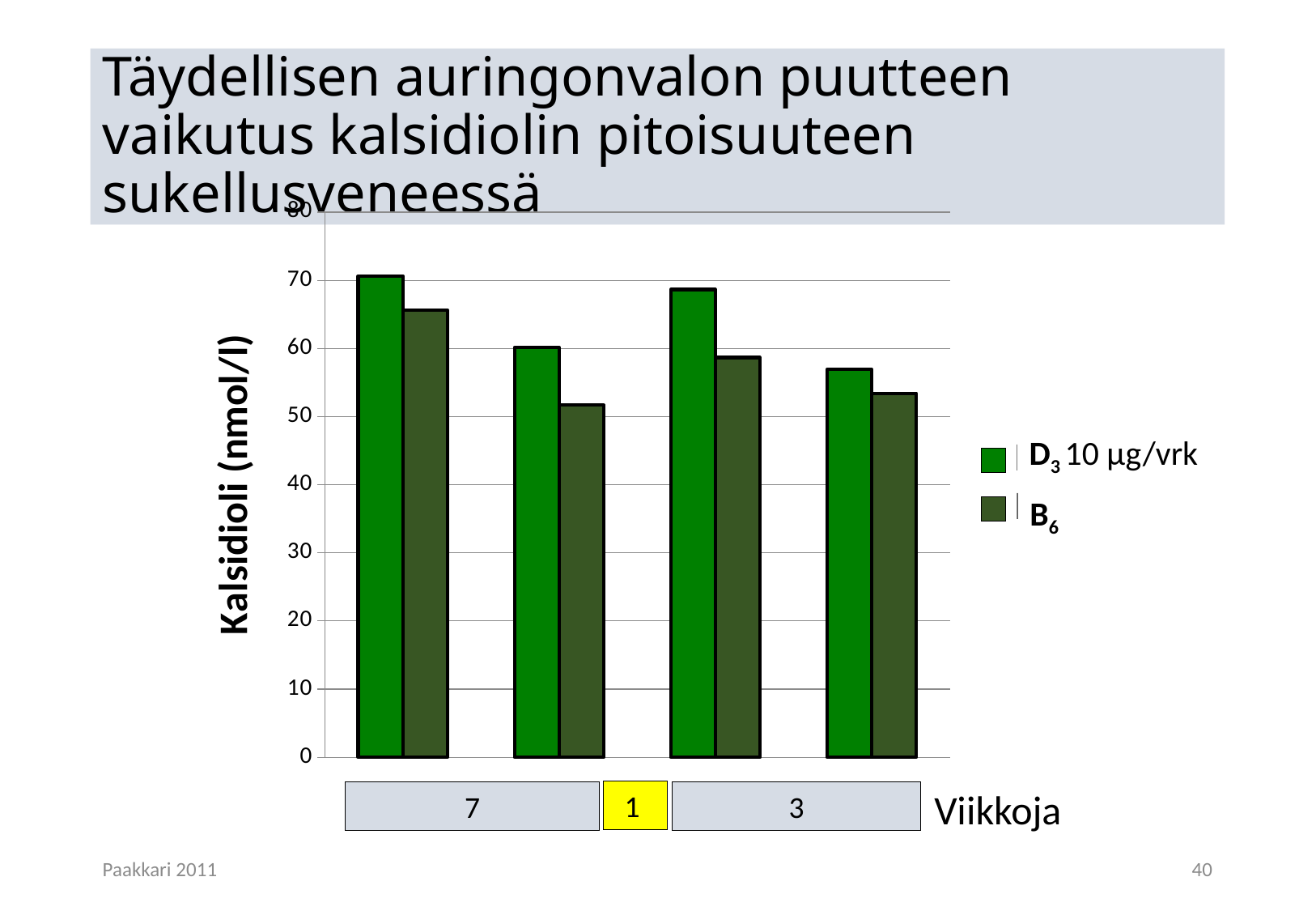
In the third group of bars from the left, is the D3 10 µg/vrk bar greater or less than 60? greater Which series is shown in bright green in the legend? D3 10 µg/vrk In the second group of bars from the left, is the B6 bar greater or less than 60? less How many groups of bars are plotted in the chart? 4 In the fourth group of bars from the left, is the B6 bar greater or less than 60? less What kind of chart is shown on the slide? bar chart What is the y-axis title of the chart? Kalsidioli (nmol/l) How many series does the legend list? 2 Is the D3 10 µg/vrk bar higher than the B6 bar in every group? yes Which bar in the chart is the highest overall? D3 10 µg/vrk in the first group from the left In the second group of bars from the left, which series has the larger value, D3 10 µg/vrk or B6? D3 10 µg/vrk